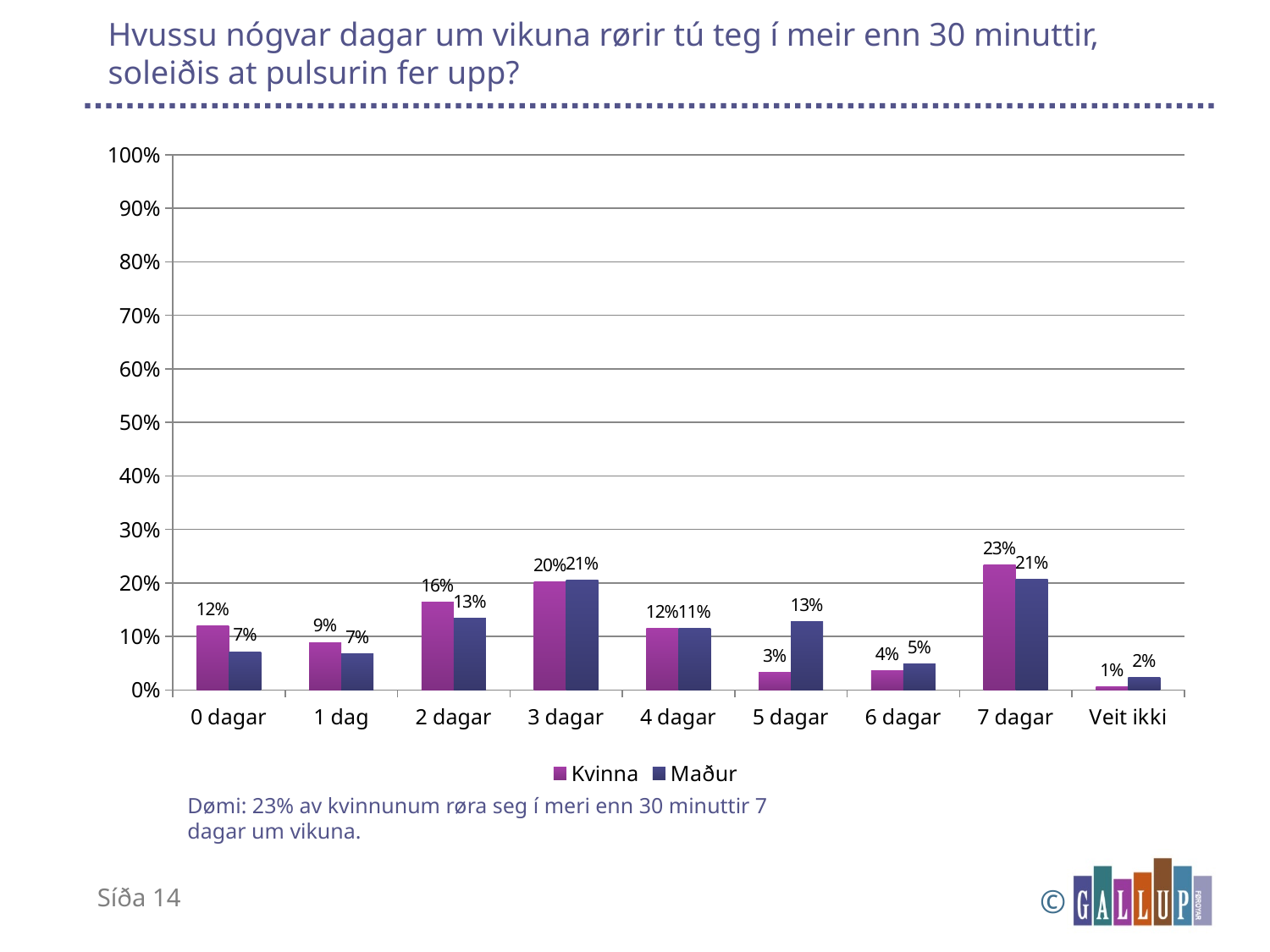
How many series does the legend list? 2 Which category has the highest value for Kvinna? 7 dagar What is the value for Kvinna at 2 dagar? 16% What is the value for Maður at 5 dagar? 13% How many categories are shown on the x axis? 9 Is the value for Kvinna at 7 dagar greater or less than 20%? greater What is the value for Kvinna at 7 dagar? 23% What kind of chart is shown on the slide? Bar chart Which category has the lowest value for Maður? Veit ikki What is the difference between the Kvinna and Maður values at 0 dagar? 5% At 2 dagar, which series has the larger value, Kvinna or Maður? Kvinna What is the difference between the Maður and Kvinna values at 5 dagar? 10%